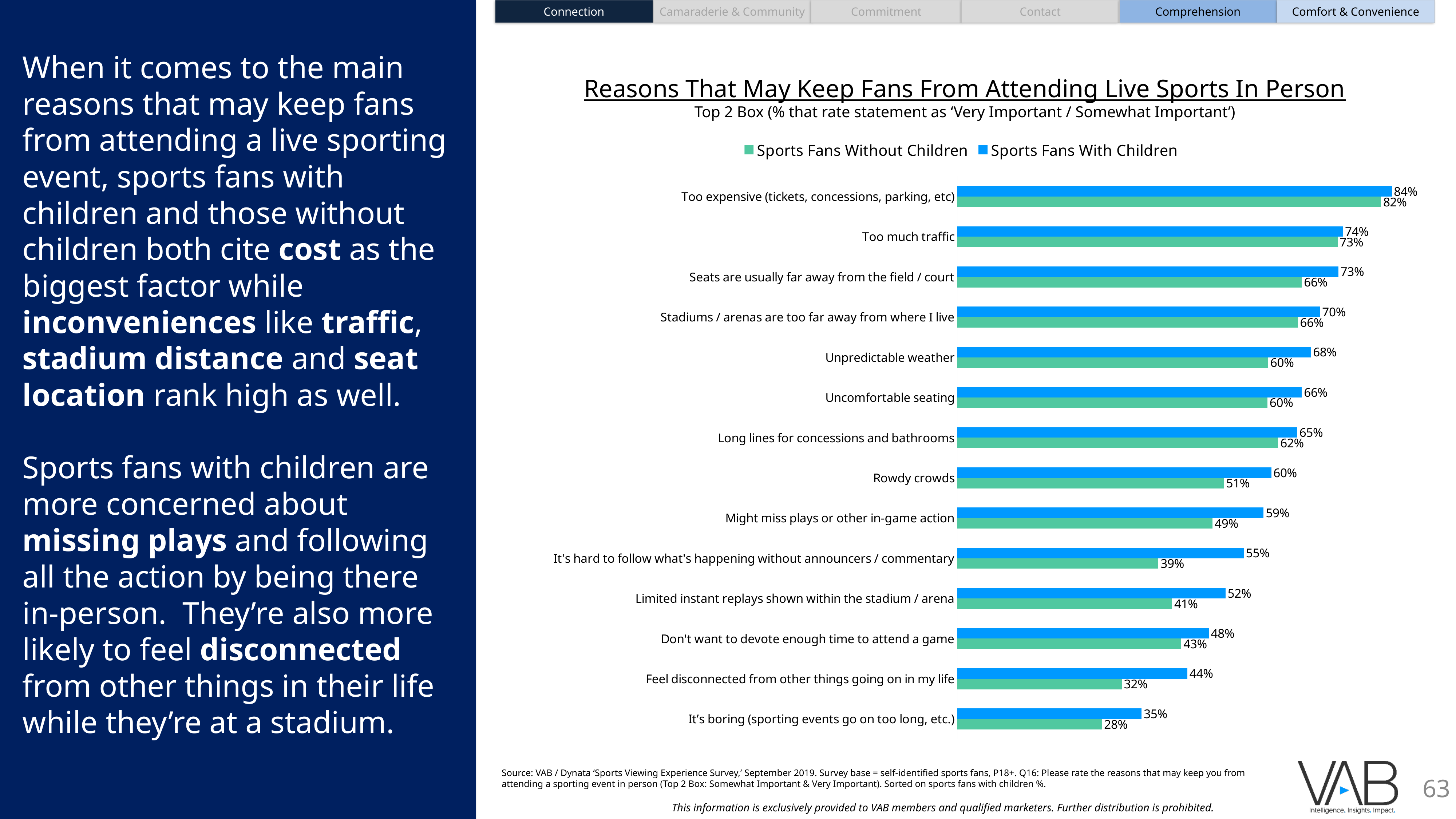
How many series does the legend list? 2 What is the value for Sports Fans With Children for 'Feel disconnected from other things going on in my life'? 44% Which reason has the lowest value for Sports Fans With Children? It's boring (sporting events go on too long, etc.) Which colour represents Sports Fans With Children in the chart? Blue For 'Might miss plays or other in-game action', which group has the higher value? Sports Fans With Children How many reasons are listed in the chart? 14 What percentage of Sports Fans Without Children rate 'Rowdy crowds' as important? 51% What is the difference between the two groups for 'Unpredictable weather'? 8 percentage points Which reason has the highest value for Sports Fans Without Children? Too expensive (tickets, concessions, parking, etc) What is the difference between Sports Fans With Children and Sports Fans Without Children for 'It's hard to follow what's happening without announcers / commentary'? 16 percentage points What type of chart is shown on the slide? Bar chart What percentage of Sports Fans With Children rate 'Too expensive (tickets, concessions, parking, etc)' as important? 84%